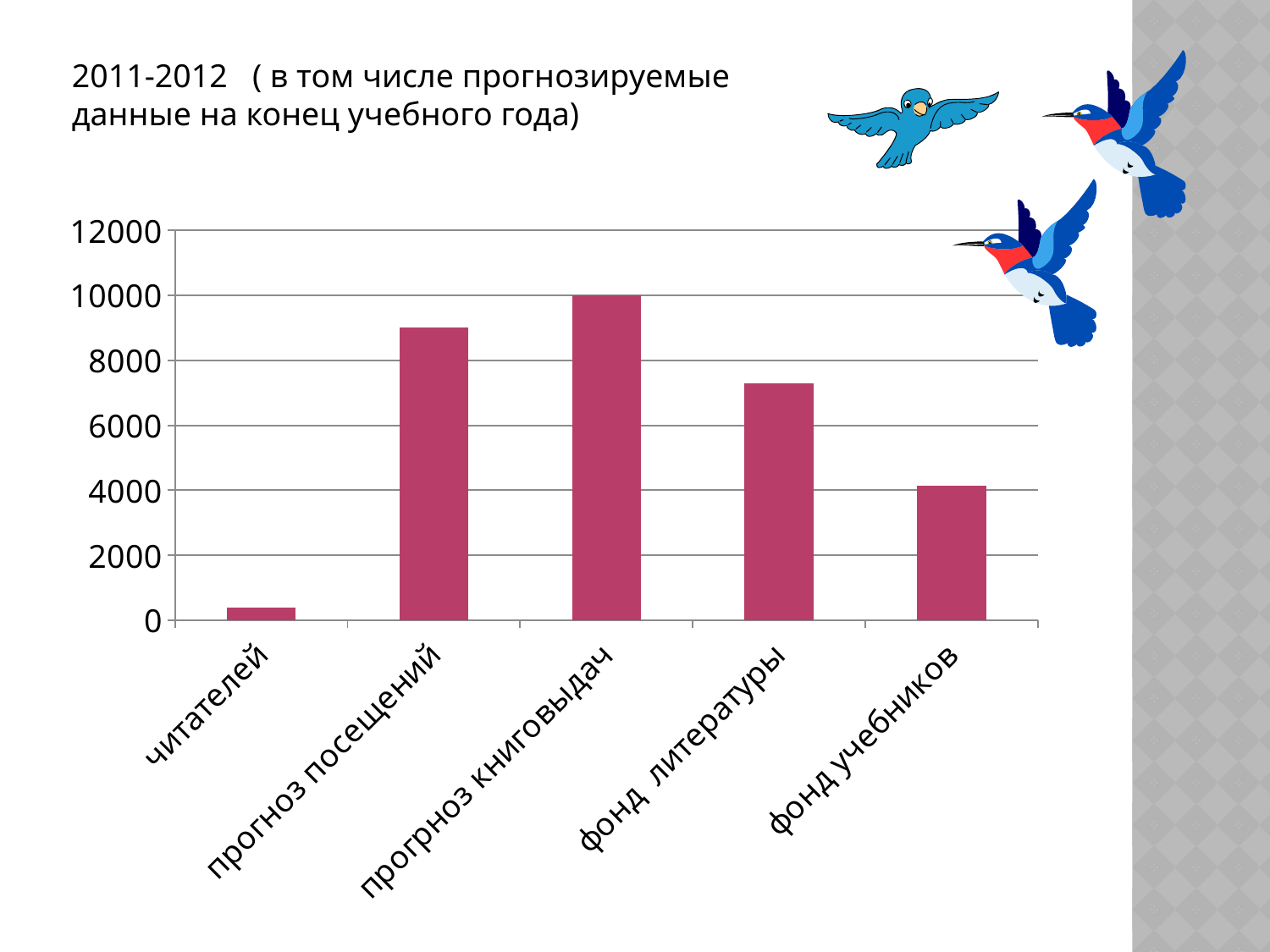
Is the value for фонд литературы greater or less than 8000? less What kind of chart is shown on the slide? bar chart Is the value for фонд учебников greater or less than 6000? less Is the value for читателей greater or less than 2000? less Which category has the lowest value in the chart? читателей Which is larger, the value for прогноз посещений or the value for фонд литературы? прогноз посещений What is the value for прогрноз книговыдач? 10000 Which is larger, the value for фонд учебников or the value for фонд литературы? фонд литературы What is the highest value shown on the vertical axis of the chart? 12000 How many categories are plotted in the chart? 5 Which category has the highest value in the chart? прогрноз книговыдач